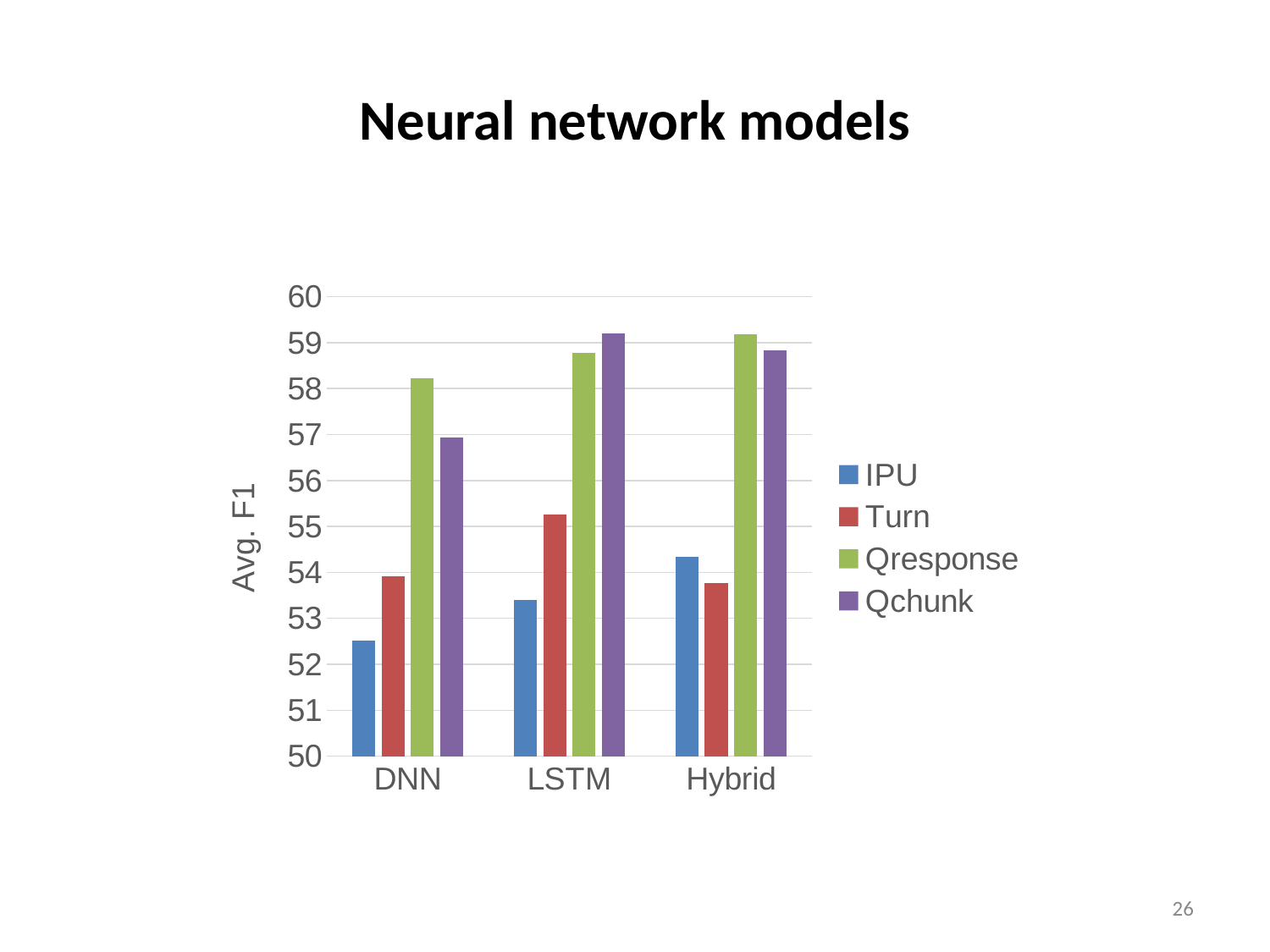
Is the Qchunk value for DNN greater or less than 56? greater How many neural network models (categories) are shown on the x axis? 3 Which series has the lowest value for DNN? IPU Do the IPU values rise or fall moving from DNN to LSTM to Hybrid? rise What is the label of the vertical axis? Avg. F1 Is the Turn value for LSTM greater or less than 55? greater How many series does the legend list? 4 Is the Turn value for Hybrid greater or less than 54? less Which model has the highest IPU value? Hybrid For DNN, which is larger, the Qresponse value or the Qchunk value? Qresponse What kind of chart is shown on the slide? bar chart